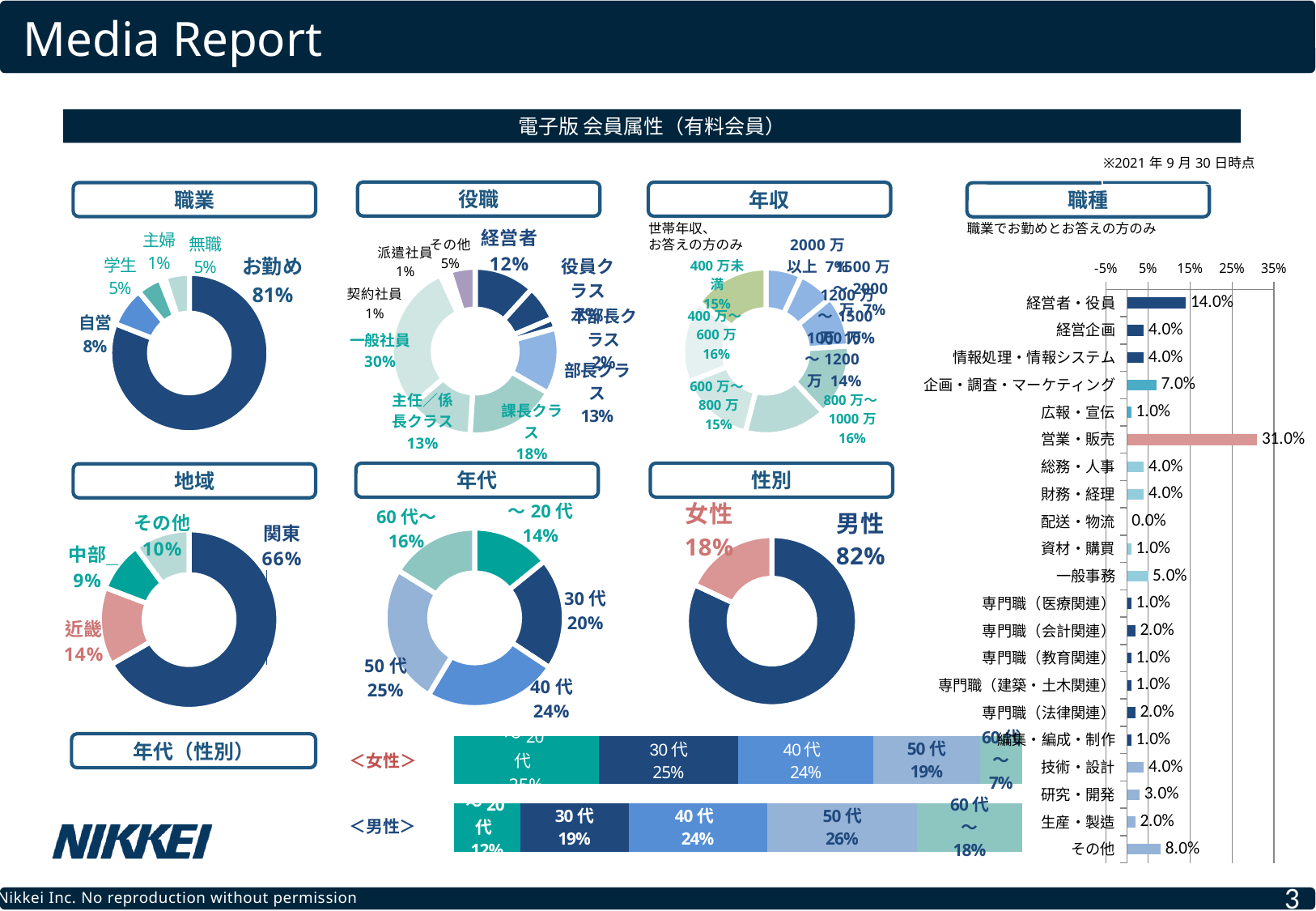
In the 職種 bar chart, what is the value for 経営者・役員? 14.0% In the 職業 chart, what percentage is お勤め? 81% In the 地域 chart, what percentage is 近畿? 14% In the 年代（性別） stacked bars, what percentage of 男性 are 50代? 26% In the 職種 bar chart, what is the difference between 営業・販売 and 経営者・役員? 17.0% In the 役職 chart, what percentage is 一般社員? 30% In the 年代 chart, how many age categories are shown? 5 In the 年代 chart, which is larger, 50代 or 30代? 50代 In the 職種 bar chart, which category has the highest value? 営業・販売 What kind of chart is the 職種 chart? bar chart In the 性別 chart, what percentage is 女性? 18% In the 職種 bar chart, which category has the lowest value? 配送・物流